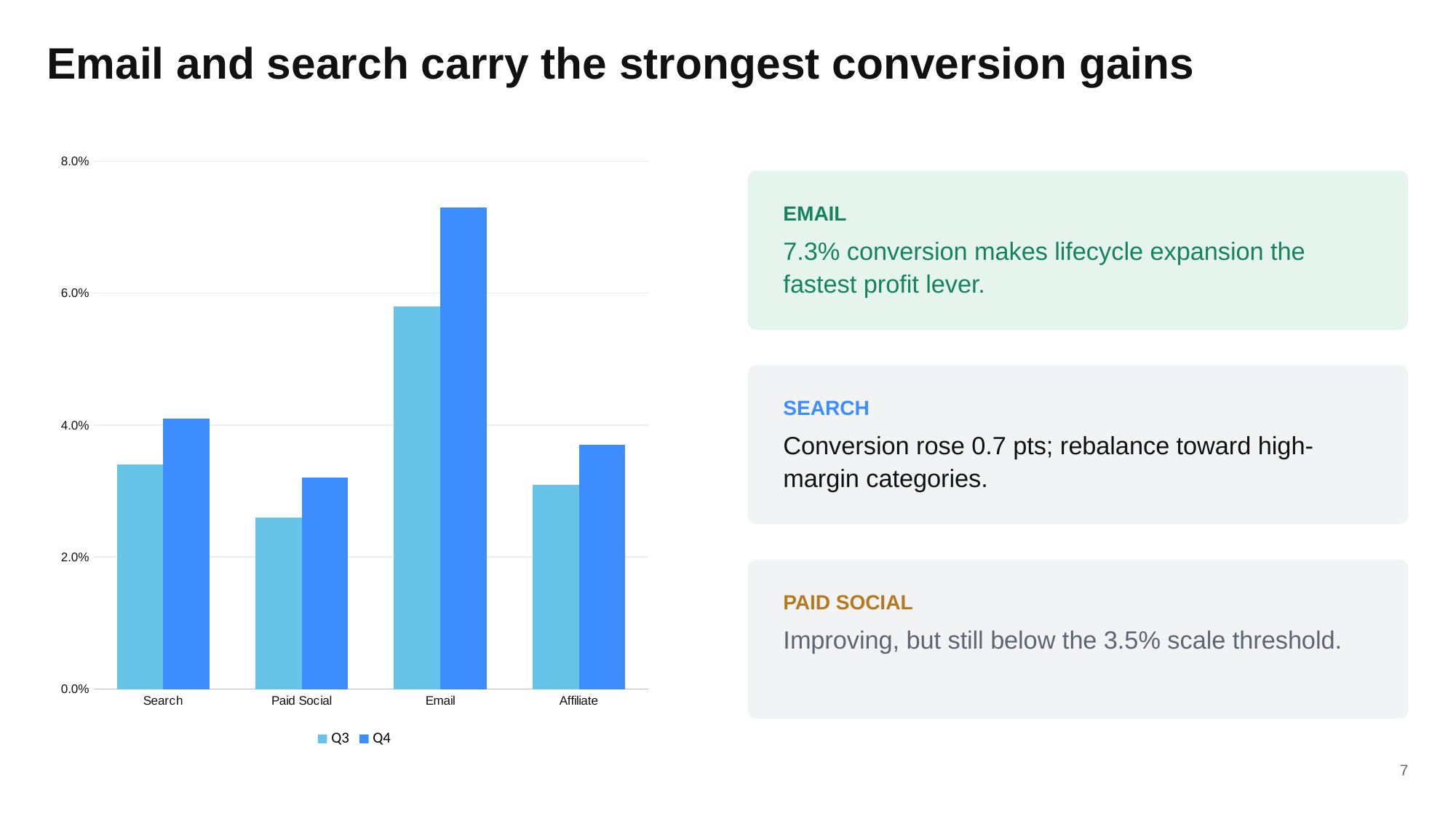
What kind of chart is shown on the slide? Bar chart Is the Q4 value for Email greater or less than 6.0%? greater What are the two series named in the chart's legend? Q3 and Q4 How many series does the chart's legend list? 2 Which category has the lowest Q3 value in the chart? Paid Social Which category has the highest Q4 value in the chart? Email Is the Q4 value for Affiliate greater or less than 4.0%? less Is the Q3 value for Email greater or less than 6.0%? less How many categories are shown on the x axis of the chart? 4 Which is larger in the chart: the Q4 value for Search or the Q4 value for Affiliate? Search Which category has the lowest Q4 value in the chart? Paid Social